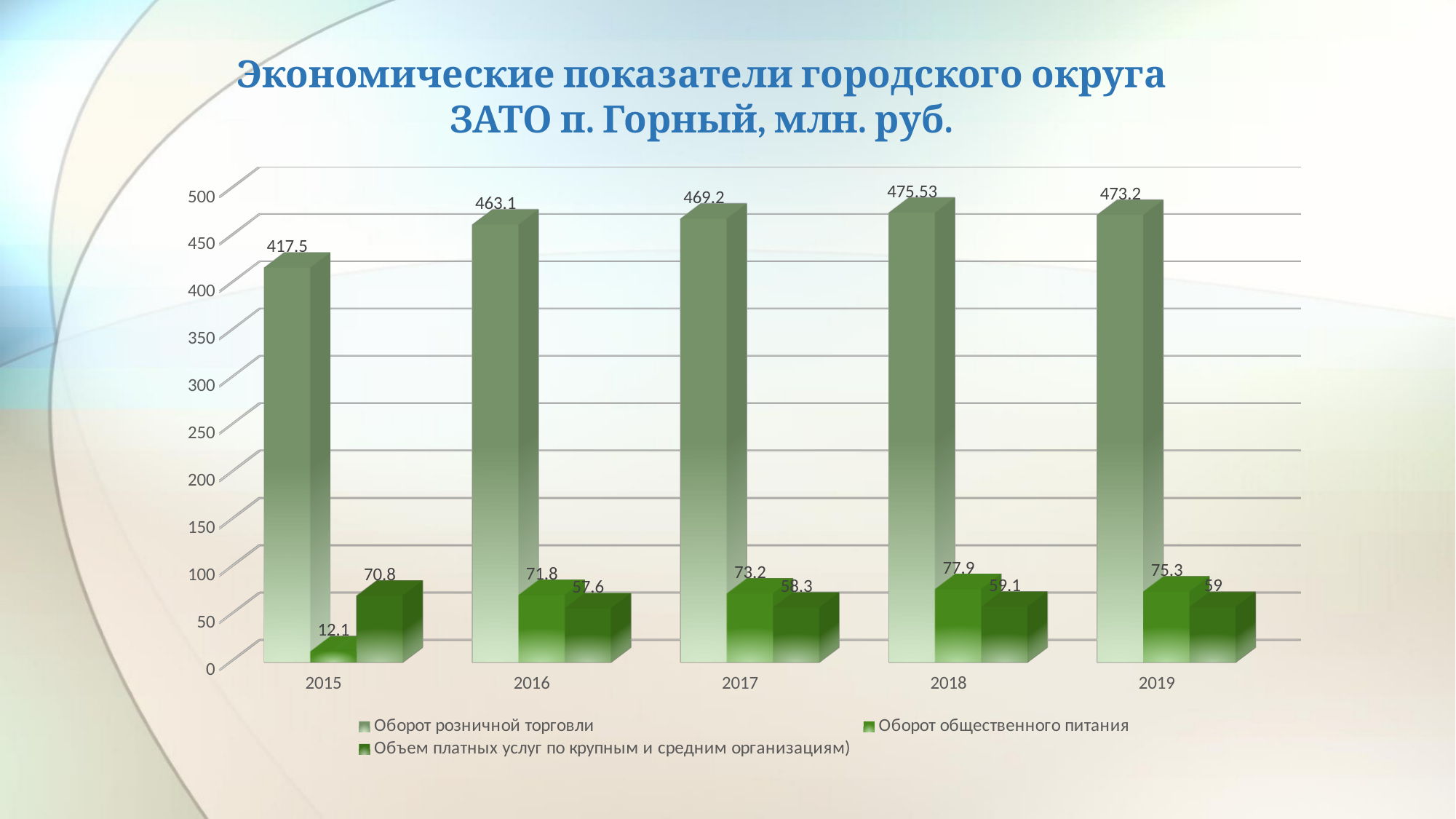
What is the value of Объем платных услуг по крупным и средним организациям in 2016? 57.6 In which year is Оборот розничной торговли highest? 2018 In which year is Оборот общественного питания lowest? 2015 Does Оборот розничной торговли rise or fall from 2015 to 2018? rise What is the value of Оборот общественного питания in 2018? 77.9 What is the value of Оборот розничной торговли in 2015? 417.5 What kind of chart is shown on the slide? bar chart Is the value of Оборот розничной торговли in 2017 greater or less than 450? greater Which is larger in 2015: Оборот общественного питания or Объем платных услуг по крупным и средним организациям? Объем платных услуг по крупным и средним организациям How many series does the legend list? 3 How many years are shown on the x axis? 5 What is the difference between Оборот розничной торговли in 2016 and in 2015? 45.6